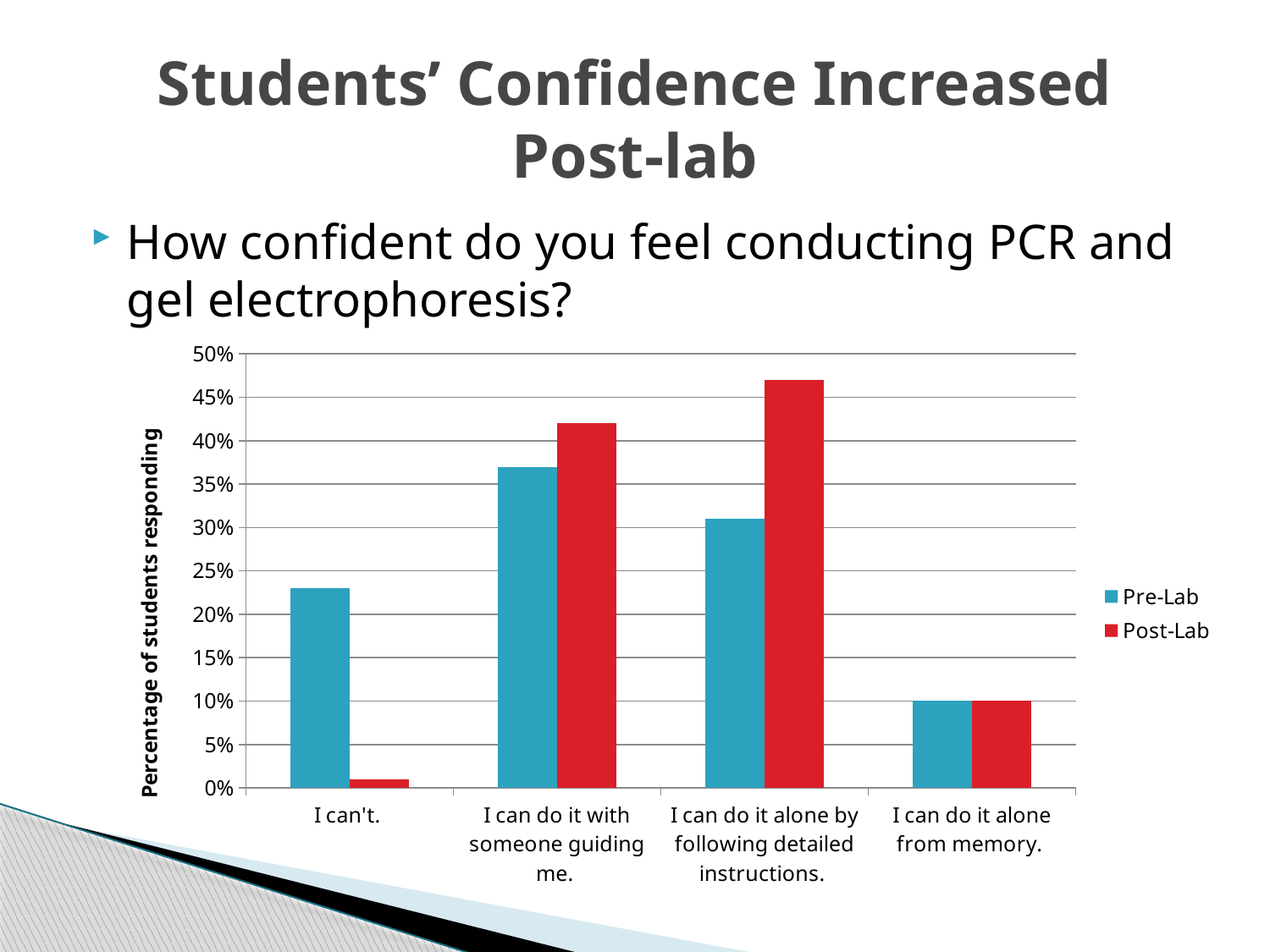
What is the label of the vertical axis? Percentage of students responding Is the Pre-Lab value for "I can't." greater or less than 20%? greater Which category has the highest Post-Lab value? I can do it alone by following detailed instructions. What is the Post-Lab value for "I can do it alone from memory."? 10% How many series does the legend list? 2 Is the Post-Lab value for "I can do it alone by following detailed instructions." greater or less than 45%? greater For "I can do it with someone guiding me.", which is larger, the Pre-Lab or the Post-Lab value? Post-Lab Which category has the highest Pre-Lab value? I can do it with someone guiding me. How many response categories are shown on the x axis? 4 Which category has the lowest Post-Lab value? I can't. What kind of chart is shown on the slide? bar chart What is the Pre-Lab value for "I can do it alone from memory."? 10%